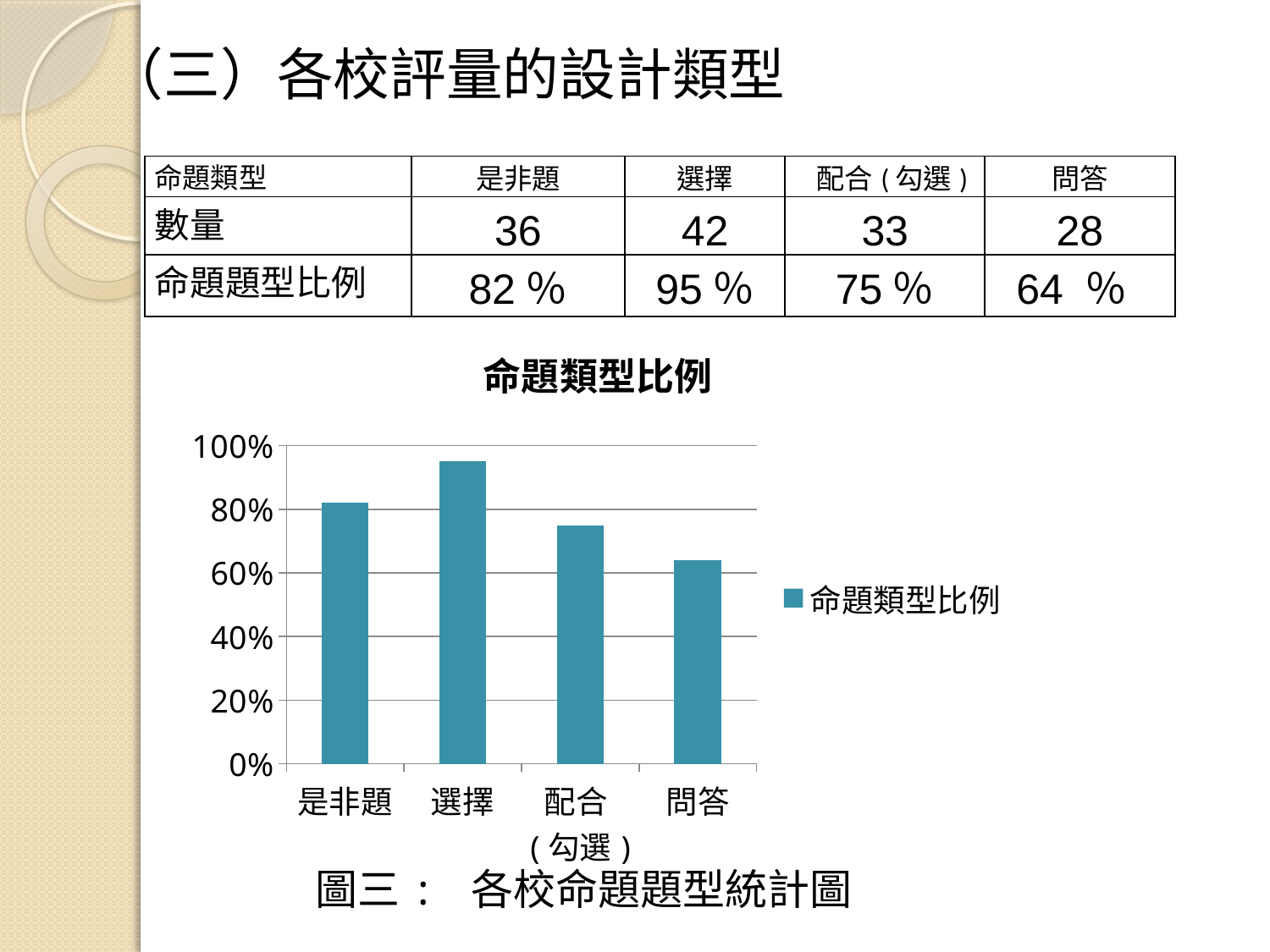
What is the difference between the 命題題型比例 for 選擇 and for 問答, using the values printed in the table? 31 % What type of chart is shown on the slide? bar chart How many categories are shown on the x axis of the chart? 4 Is the value for 配合（勾選） greater or less than 60%? greater What is the 命題題型比例 value for 選擇 as printed in the table? 95 % Is the value for 問答 greater or less than 80%? less What is the title of the chart? 命題類型比例 Which category has the lowest bar in the chart? 問答 How many series does the chart legend list? 1 Is the value for 選擇 greater or less than 80%? greater Which is larger, the bar for 是非題 or the bar for 配合（勾選）? 是非題 Which category has the highest bar in the chart? 選擇